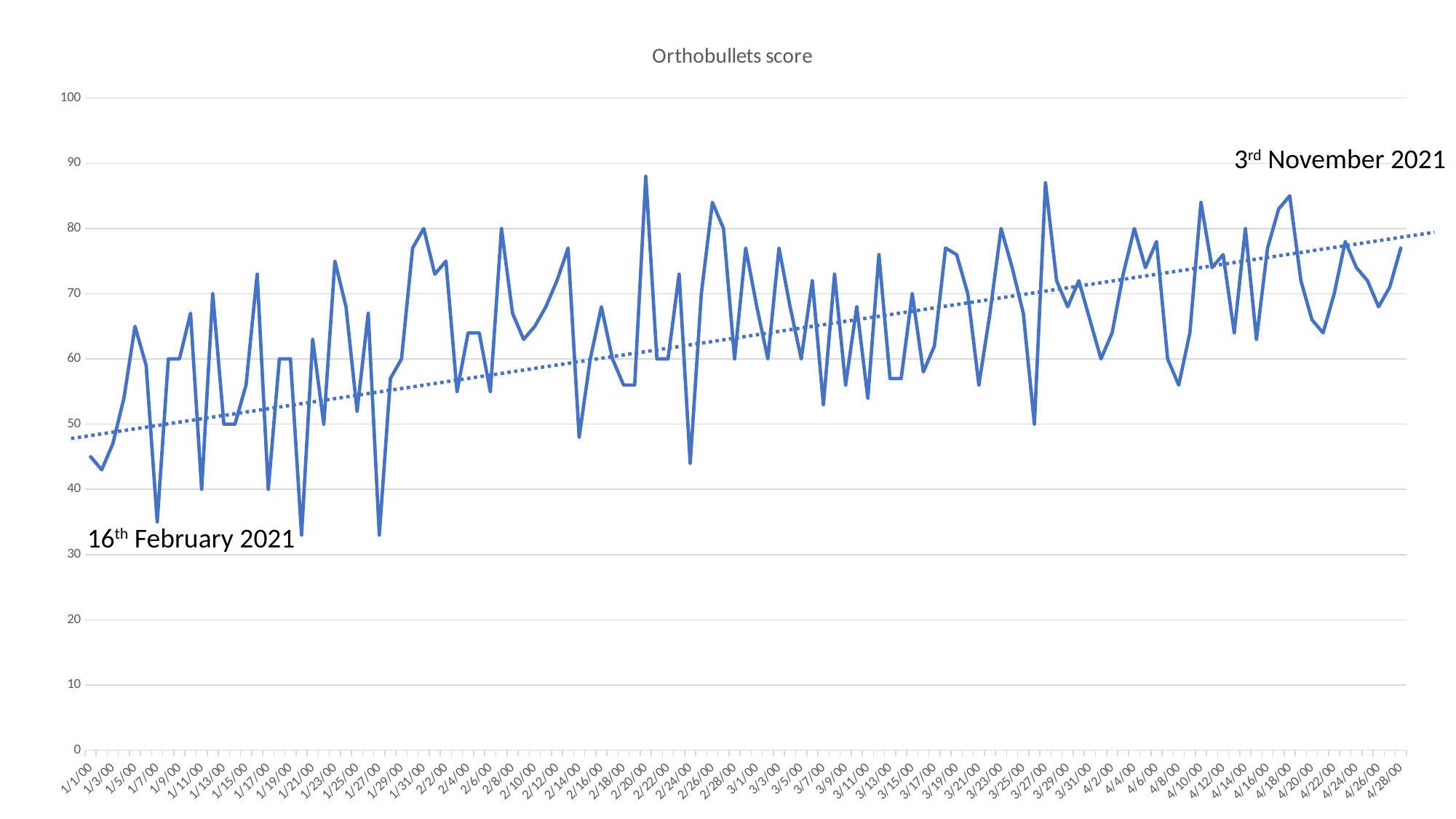
What kind of chart is shown on the slide? line chart What is the highest value shown on the y axis? 100 Is the lowest point on the line greater or less than 40? less What is the title of the chart? Orthobullets score Is the value for 1/1/00 greater or less than 40? greater Is the highest point on the line greater or less than 80? greater Which date annotation is placed near the start of the line, at the lower left of the chart? 16th February 2021 Do the Orthobullets score values generally rise or fall along the x axis, as shown by the dotted trendline? rise